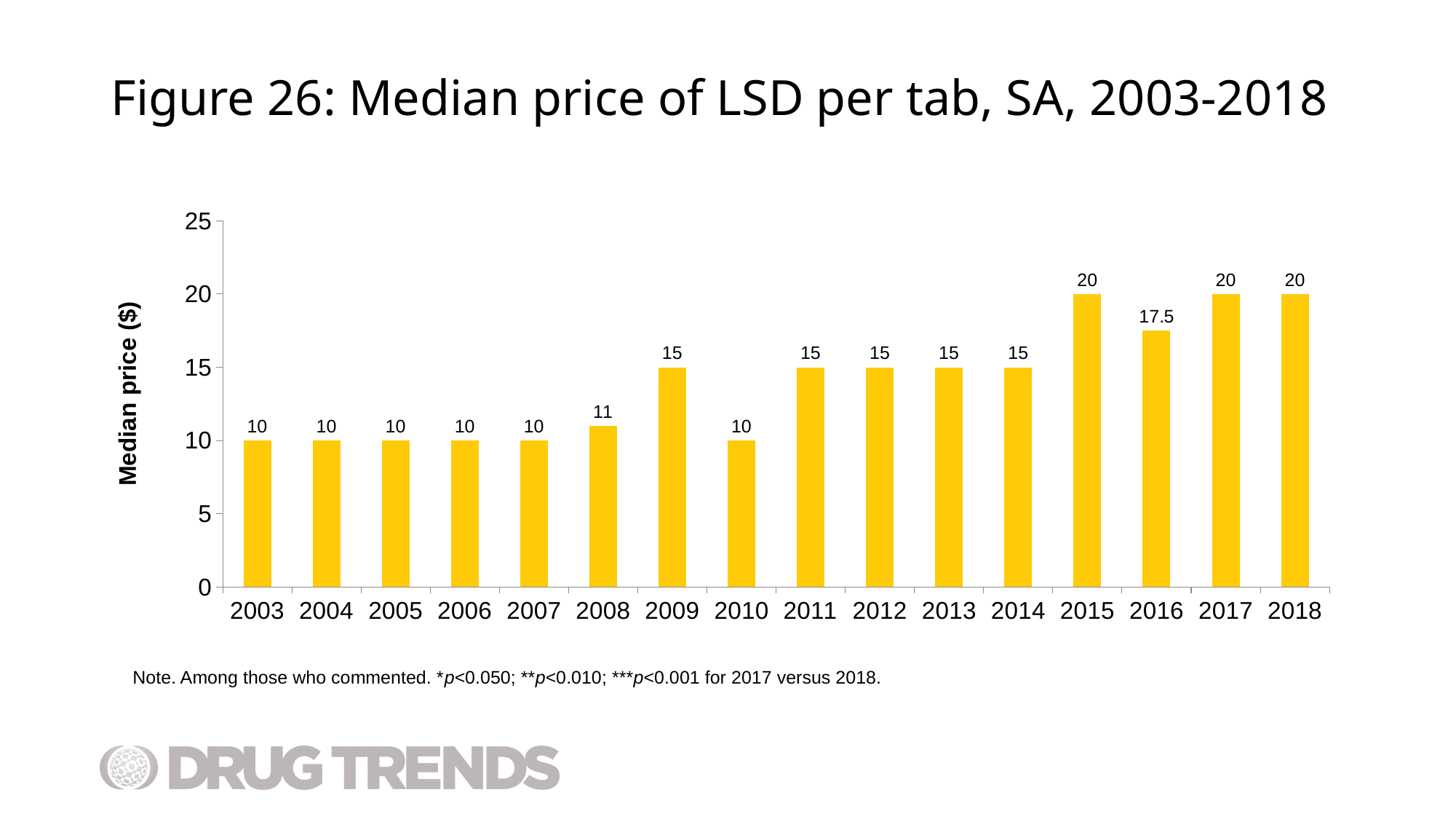
What is the difference between the median price in 2009 and the median price in 2008? 4 How many years are shown on the x axis of the chart? 16 What is the median price of LSD per tab in 2010? 10 What is the median price of LSD per tab in 2018? 20 Overall, does the median price of LSD per tab rise or fall from 2003 to 2018? rise What is the median price of LSD per tab in 2016? 17.5 Which is larger, the median price in 2014 or the median price in 2015? 2015 What is the median price of LSD per tab in 2008? 11 What is the difference between the median price in 2015 and the median price in 2016? 2.5 Is the median price in 2016 greater or less than 15? greater What kind of chart is shown on the slide? bar chart